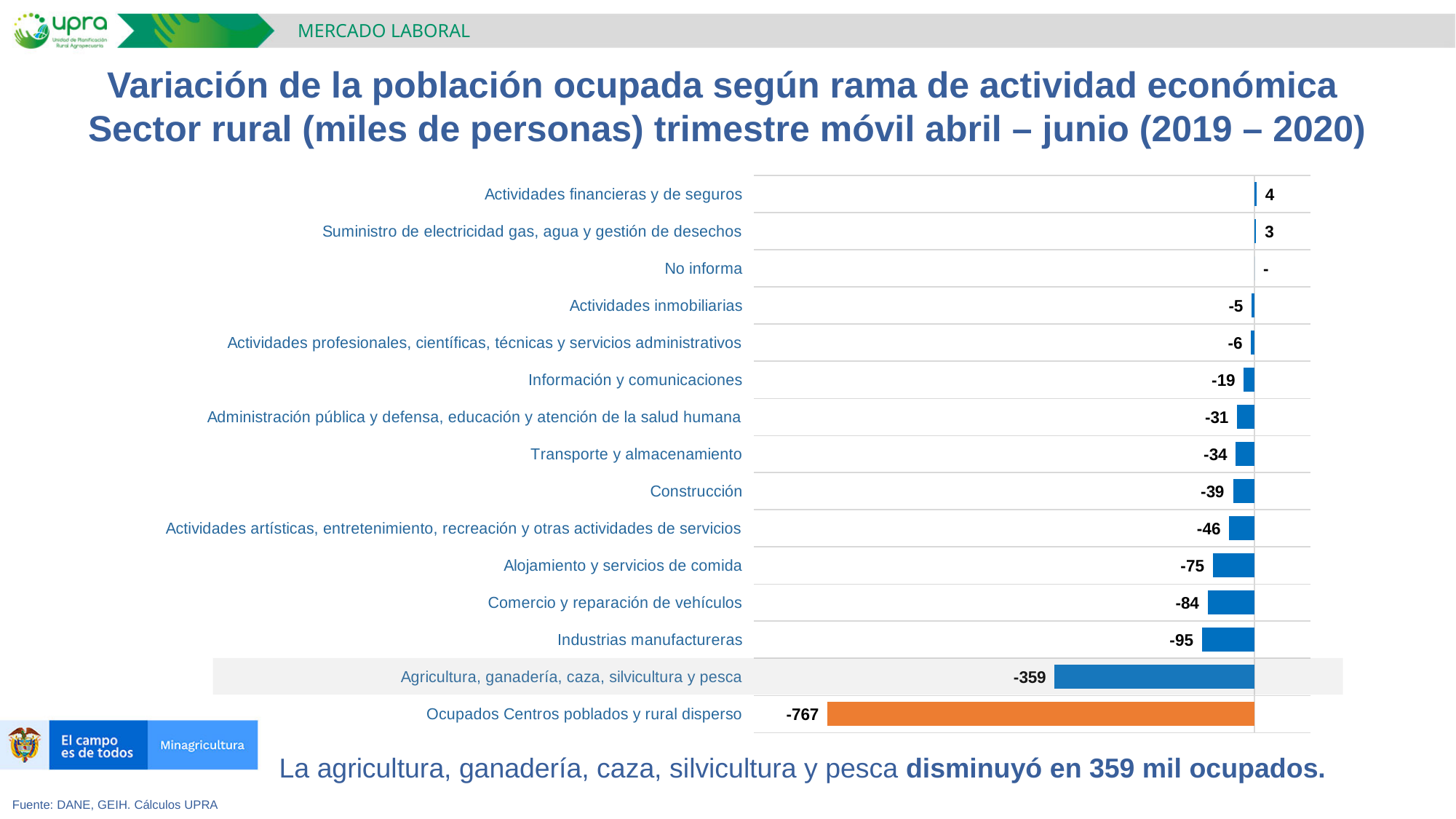
Which category has the highest (most positive) value? Actividades financieras y de seguros Which bar is shown in orange rather than blue? Ocupados Centros poblados y rural disperso What is the difference between the values for Comercio y reparación de vehículos and Alojamiento y servicios de comida? 9 How many categories are shown in the chart? 15 What kind of chart is shown on the slide? Bar chart What is the value for Actividades financieras y de seguros? 4 Which category has the lowest (most negative) value? Ocupados Centros poblados y rural disperso What is the value for Agricultura, ganadería, caza, silvicultura y pesca? -359 What is the value for Alojamiento y servicios de comida? -75 What is the value for Industrias manufactureras? -95 What is the value for Ocupados Centros poblados y rural disperso? -767 Which has a larger decline, Construcción or Transporte y almacenamiento? Construcción